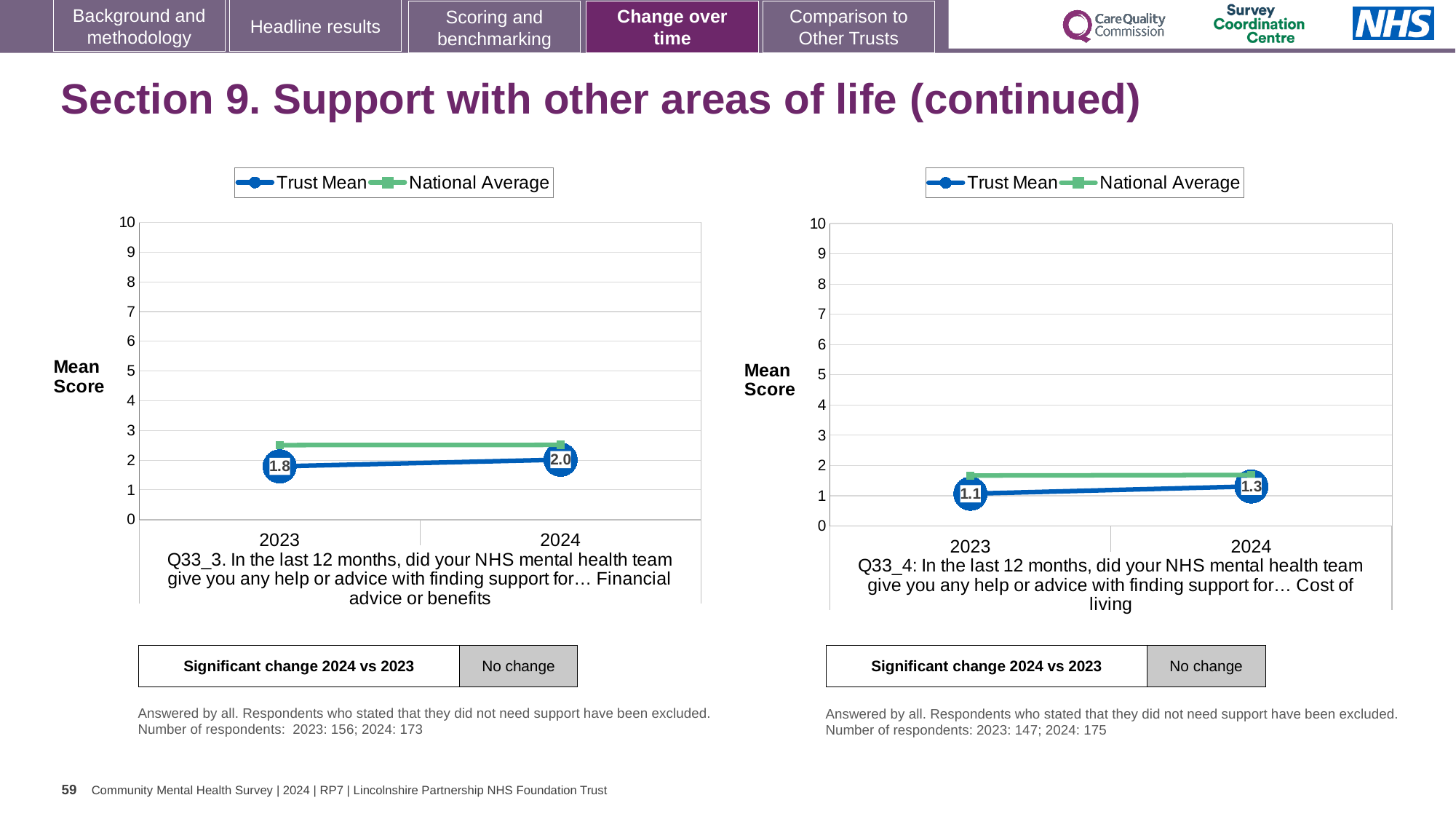
In the left chart (Q33_3, Financial advice or benefits), what is the Trust Mean for 2024? 2.0 In the right chart (Q33_4), what is the difference between the Trust Mean in 2024 and in 2023? 0.2 In the left chart (Q33_3), which is higher in 2023, the Trust Mean or the National Average? National Average In the right chart (Q33_4, Cost of living), what is the Trust Mean for 2024? 1.3 In the right chart (Q33_4), is the National Average for 2023 greater or less than 2? less What type of chart is the right chart (Q33_4)? line chart How many series does the legend of the left chart list? 2 In the right chart (Q33_4), does the Trust Mean rise or fall from 2023 to 2024? rise In the left chart (Q33_3), is the National Average for 2023 greater or less than 2? greater In the left chart (Q33_3, Financial advice or benefits), what is the Trust Mean for 2023? 1.8 In the right chart (Q33_4, Cost of living), what is the Trust Mean for 2023? 1.1 In the left chart (Q33_3), by how much did the Trust Mean change from 2023 to 2024? 0.2